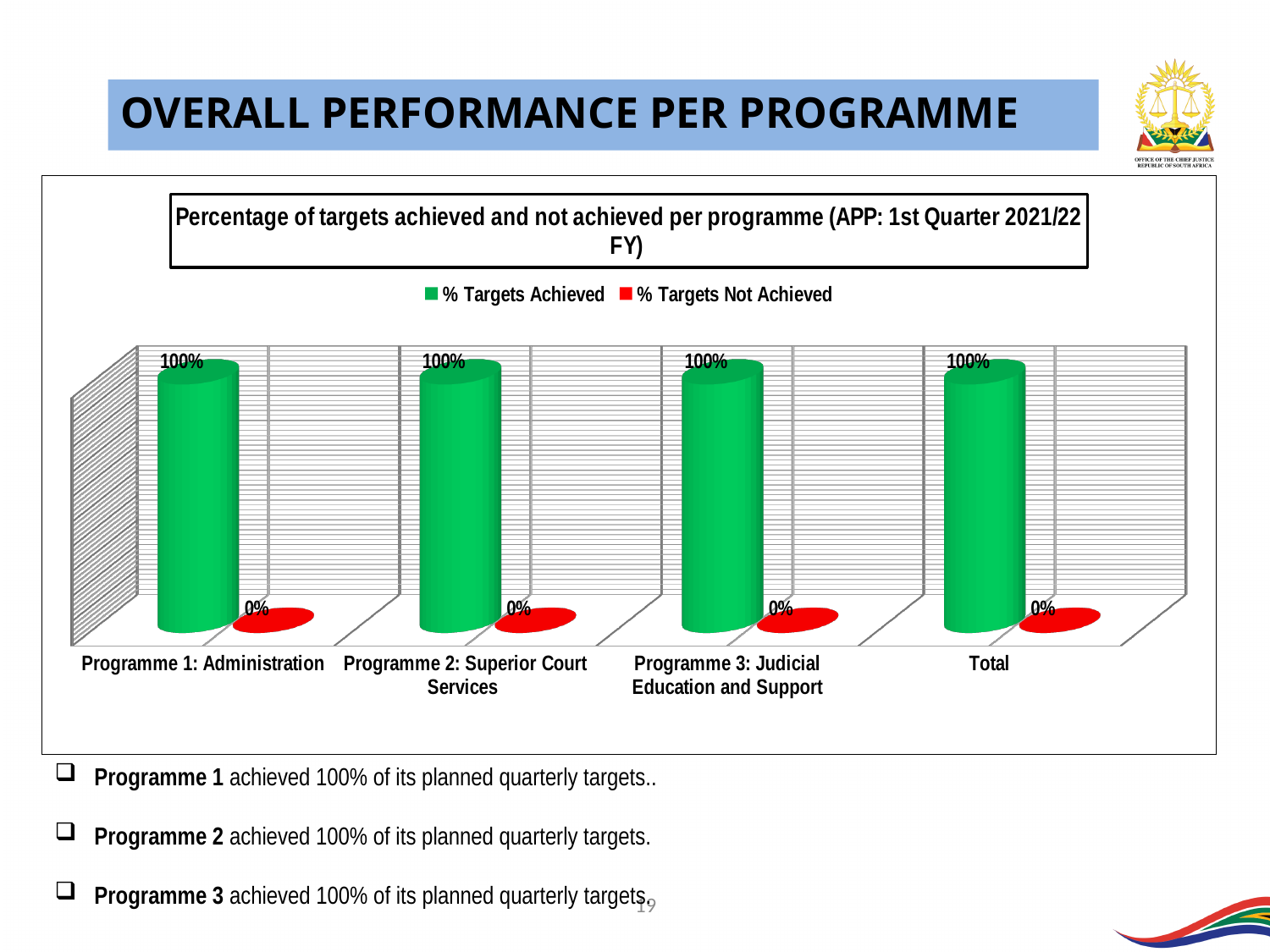
What is the % Targets Achieved value for Programme 3: Judicial Education and Support? 100% What is the % Targets Achieved value for Programme 1: Administration? 100% What kind of chart is shown on the slide? Bar chart What is the title of the chart? Percentage of targets achieved and not achieved per programme (APP: 1st Quarter 2021/22 FY) How many series does the legend list? 2 Which colour represents % Targets Not Achieved in the chart? Red How many categories are shown on the x axis of the chart? 4 What is the % Targets Not Achieved value for Programme 2: Superior Court Services? 0% What is the difference between % Targets Achieved and % Targets Not Achieved for Programme 1: Administration? 100% What is the total of % Targets Achieved and % Targets Not Achieved for Programme 2: Superior Court Services? 100% What is the % Targets Not Achieved value for Total? 0% Which is larger for Total: % Targets Achieved or % Targets Not Achieved? % Targets Achieved